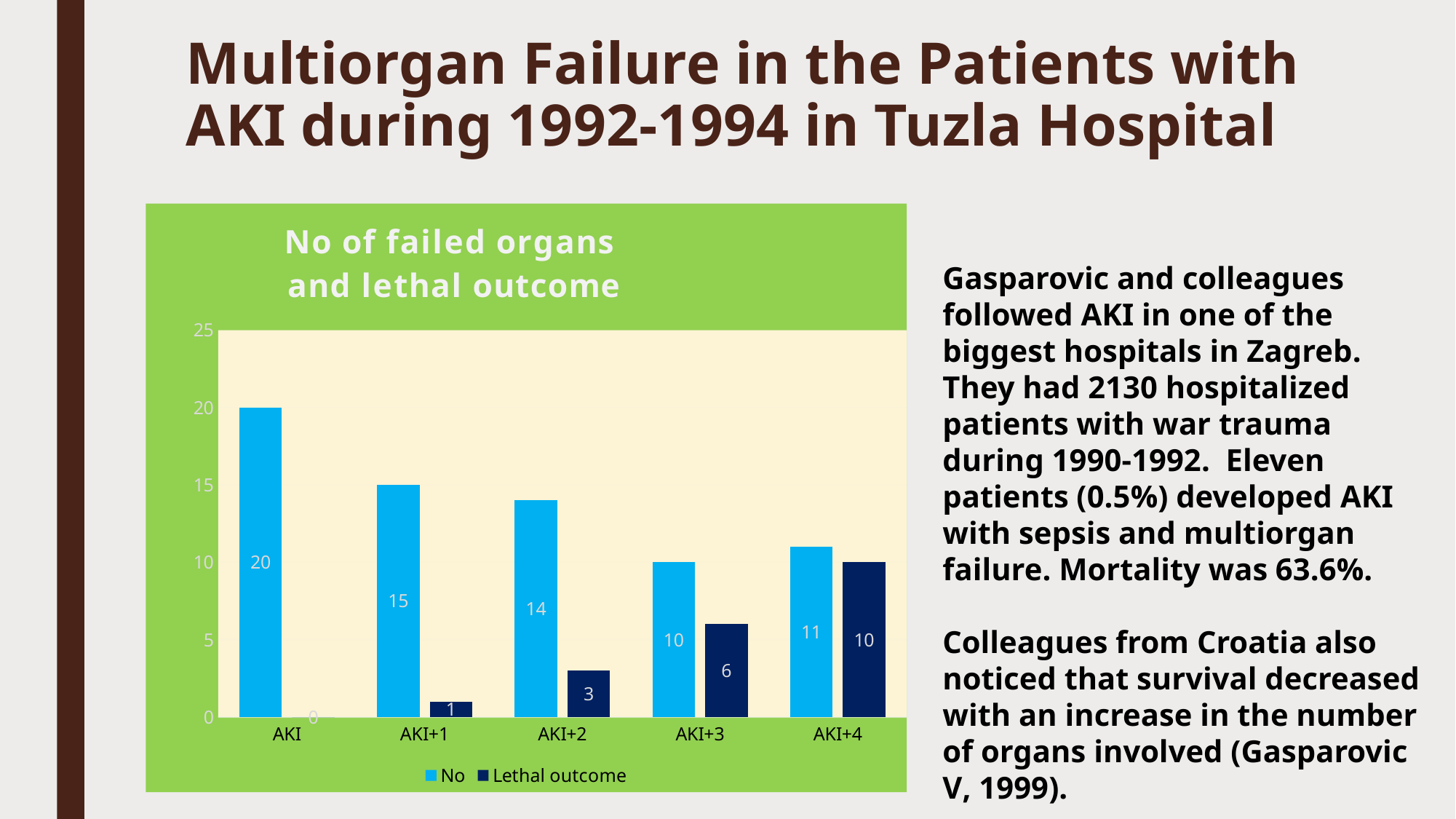
What is the value of the "No" series for AKI+2? 14 Which is larger: the "No" value for AKI+1 or the "No" value for AKI+3? AKI+1 What is the difference between the "No" value and the "Lethal outcome" value for AKI+4? 1 What is the value of the "Lethal outcome" series for AKI+1? 1 How many series does the legend list? 2 What is the value of the "Lethal outcome" series for AKI+3? 6 Which category has the lowest value in the "Lethal outcome" series? AKI Is the "No" value for AKI greater or less than 15? greater What is the title of the chart? No of failed organs and lethal outcome How many categories are shown on the x axis? 5 Which category has the highest value in the "No" series? AKI What kind of chart is shown on the slide? bar chart